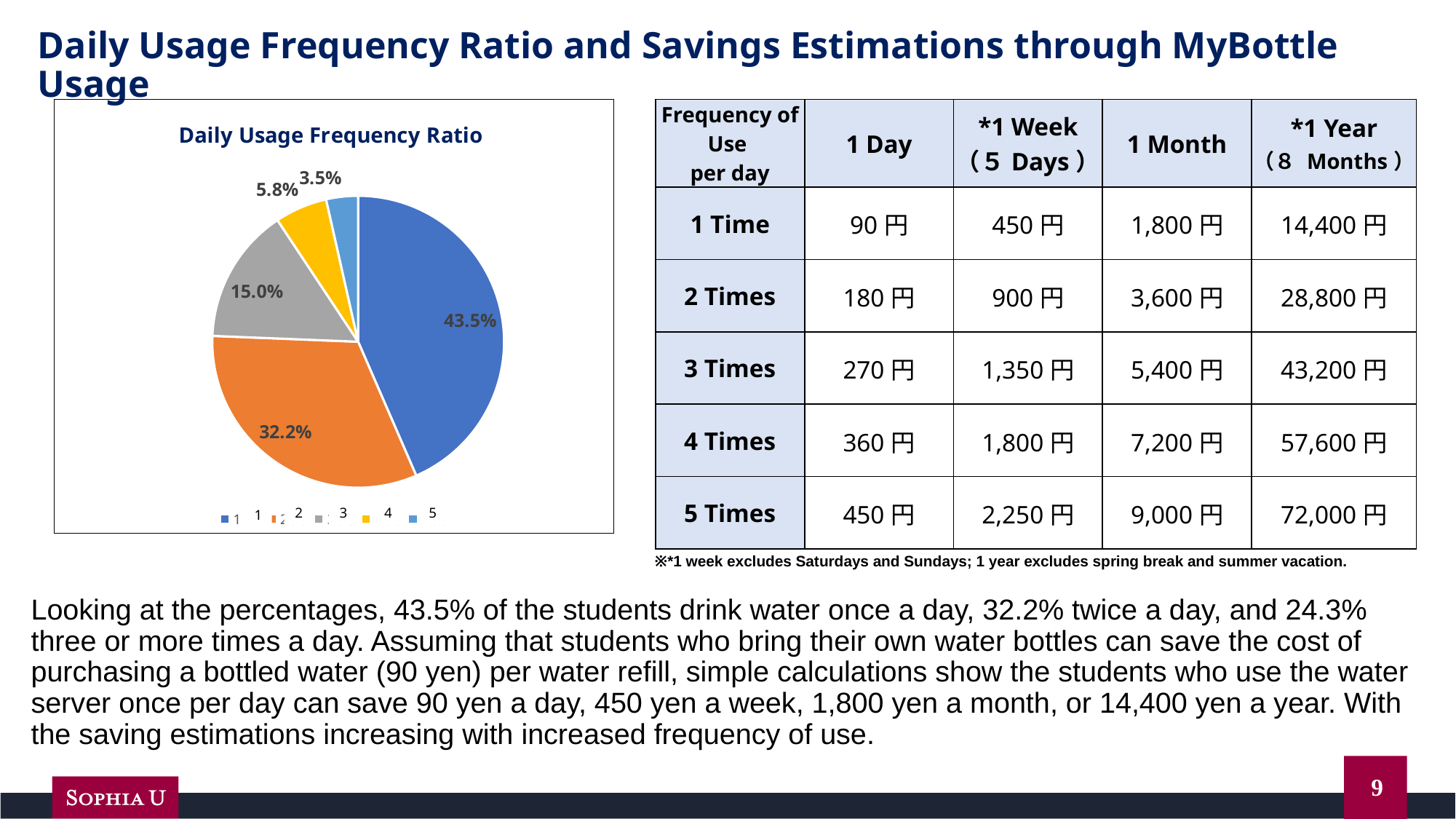
Which slice is larger in the pie chart, category 3 or category 4? 3 What percentage does the slice for category 5 represent in the pie chart? 3.5% What percentage does the slice for category 4 represent in the pie chart? 5.8% Which category has the largest slice in the pie chart? 1 What type of chart is shown on the slide? Pie chart What is the title of the chart? Daily Usage Frequency Ratio What percentage does the slice for category 3 represent in the pie chart? 15.0% What is the difference in percentage points between the slices for category 1 and category 2? 11.3 Which category has the smallest slice in the pie chart? 5 How many slices does the pie chart have? 5 What percentage does the slice for category 1 represent in the Daily Usage Frequency Ratio pie chart? 43.5% What percentage does the slice for category 2 represent in the pie chart? 32.2%